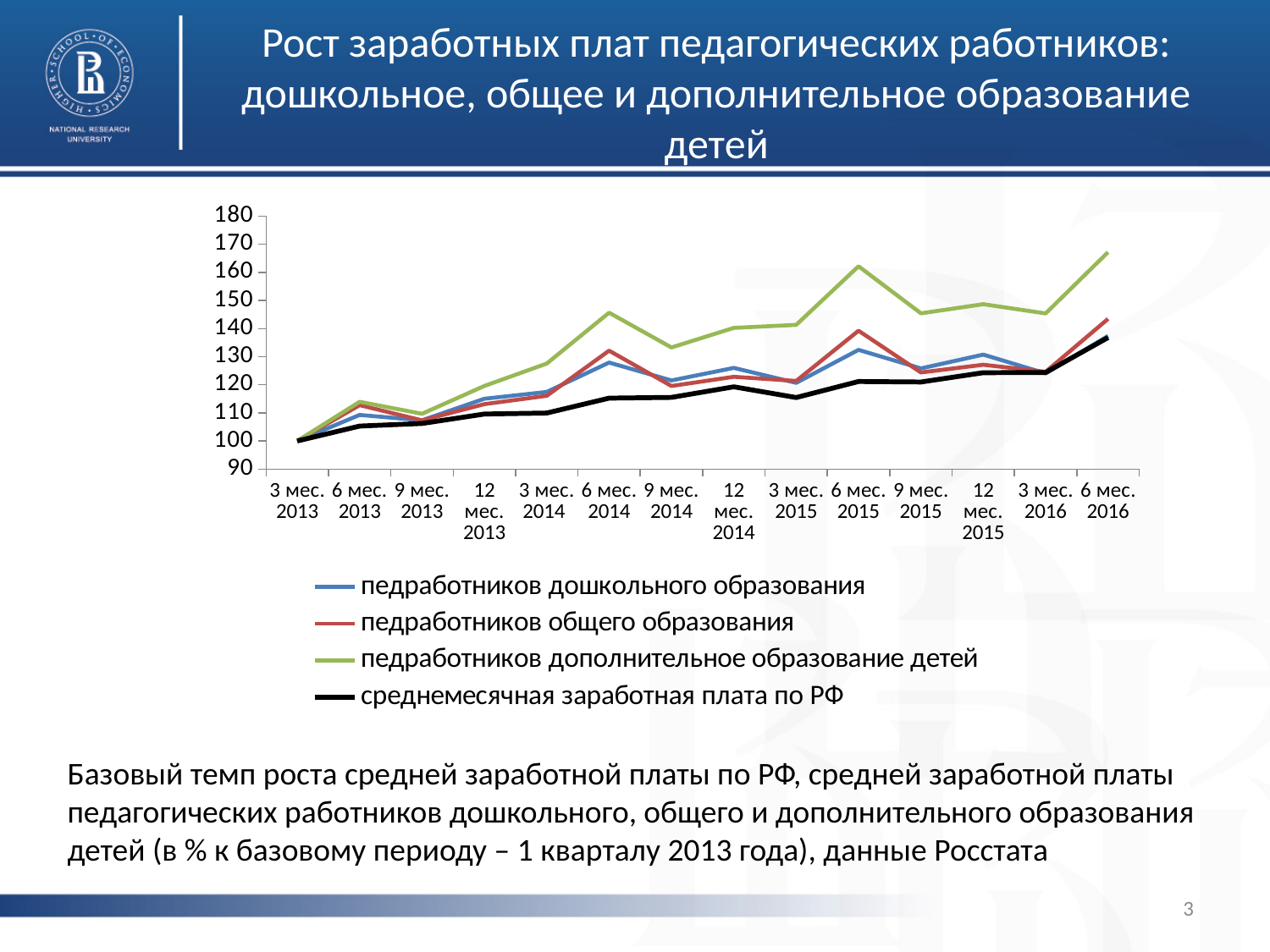
Is the value for 'среднемесячная заработная плата по РФ' at 3 мес. 2015 greater or less than 120? less What kind of chart is shown on the slide? line chart Is the value for 'педработников дополнительное образование детей' at 6 мес. 2015 greater or less than 150? greater What colour is the line for 'педработников общего образования'? red How many series does the legend list? 4 How many time points are shown along the x axis? 14 At 6 мес. 2014, which is larger: the value for 'педработников дополнительное образование детей' or for 'среднемесячная заработная плата по РФ'? педработников дополнительное образование детей Does the series 'среднемесячная заработная плата по РФ' generally rise or fall from 3 мес. 2013 to 6 мес. 2016? rise Which series has the highest value at 6 мес. 2016? педработников дополнительное образование детей What is the value of the series 'среднемесячная заработная плата по РФ' at 3 мес. 2013? 100 Is the value for 'педработников дополнительное образование детей' at 6 мес. 2016 greater or less than 160? greater